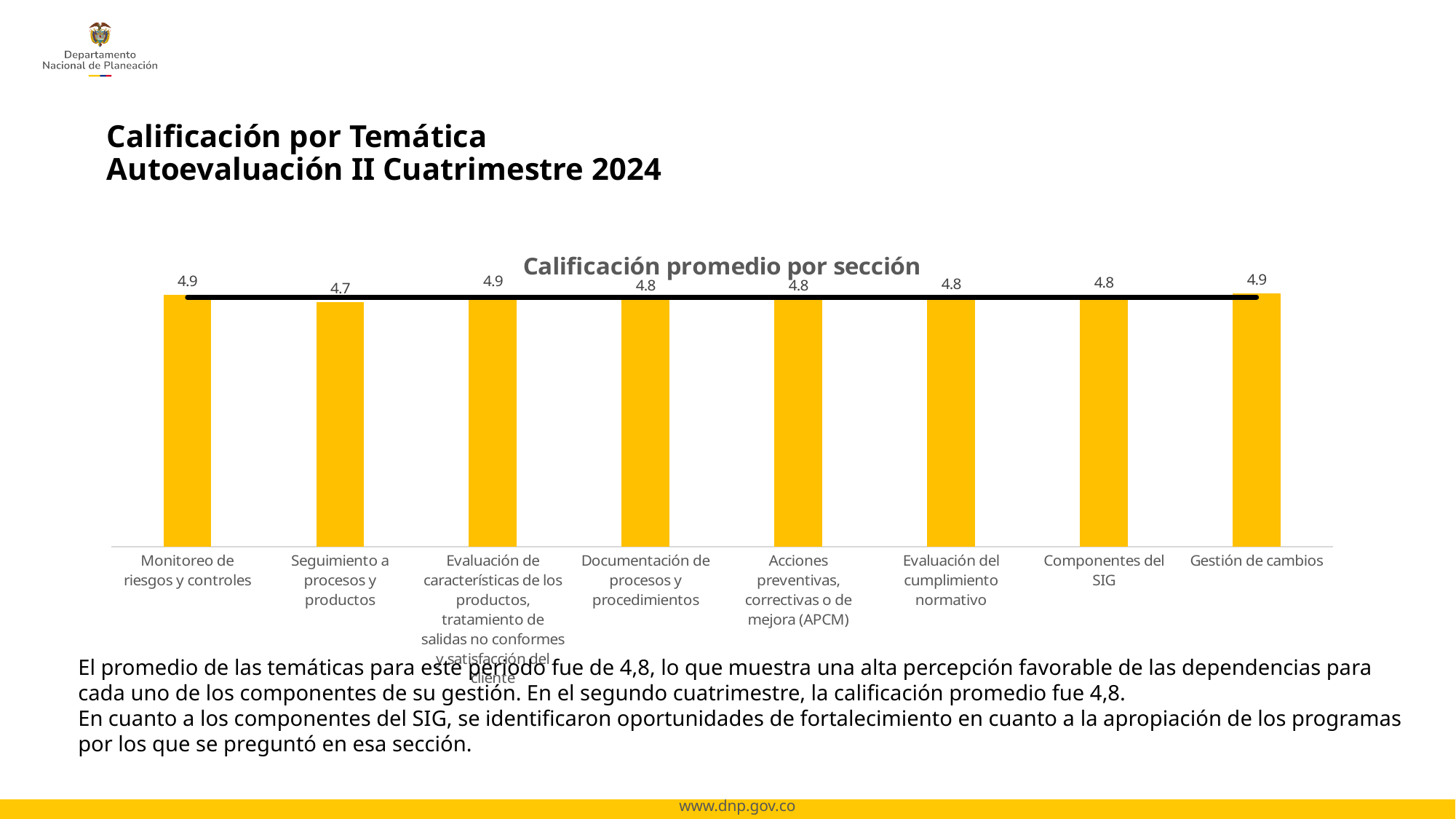
What is the title of the chart? Calificación promedio por sección Which is larger, the value for Gestión de cambios or the value for Seguimiento a procesos y productos? Gestión de cambios What is the difference between the values for Monitoreo de riesgos y controles and Seguimiento a procesos y productos? 0.2 Which category has the lowest value? Seguimiento a procesos y productos What is the value for Gestión de cambios? 4.9 What colour are the bars in the chart? Yellow What kind of chart is shown on the slide? Combination bar and line chart How many categories are shown in the chart? 8 What is the value for Monitoreo de riesgos y controles? 4.9 What is the value for Seguimiento a procesos y productos? 4.7 What is the value for Componentes del SIG? 4.8 What is the value for Documentación de procesos y procedimientos? 4.8